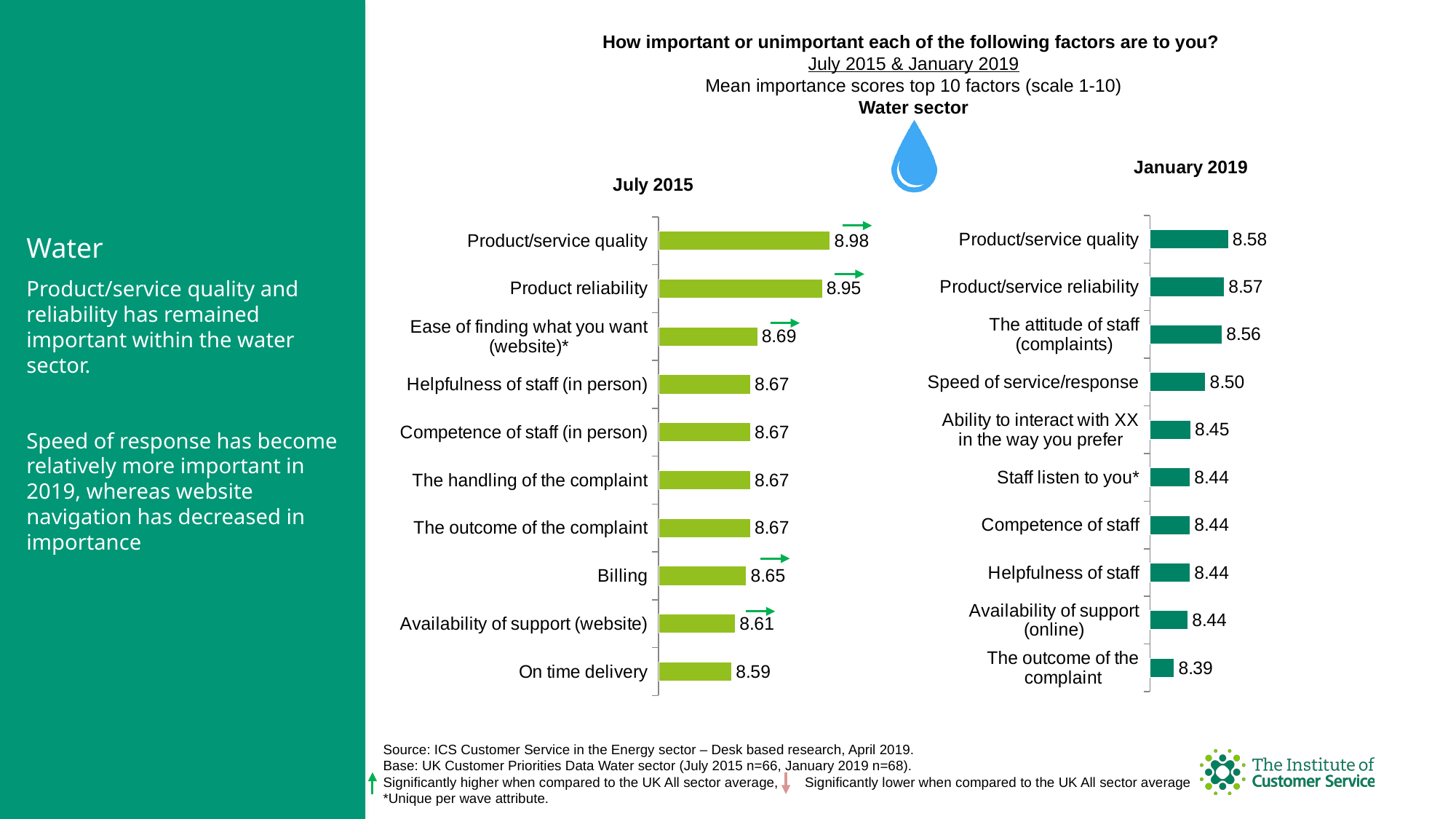
How many factors are shown in the July 2015 chart? 10 How many factors are shown in the January 2019 chart? 10 In the July 2015 chart, which factor has the highest score? Product/service quality What type of chart is used for the July 2015 data? Bar chart In the January 2019 chart, what is the score for The attitude of staff (complaints)? 8.56 In the January 2019 chart, what is the difference between the scores for Product/service quality and The outcome of the complaint? 0.19 In the January 2019 chart, what is the mean importance score for Speed of service/response? 8.50 In the July 2015 chart, what is the mean importance score for Billing? 8.65 In the July 2015 chart, what is the difference between the scores for Product/service quality and On time delivery? 0.39 Which is larger: the July 2015 score for Product/service quality or the January 2019 score for Product/service quality? July 2015 Which sector do the charts on this slide cover? Water sector In the January 2019 chart, which factor has the lowest score? The outcome of the complaint